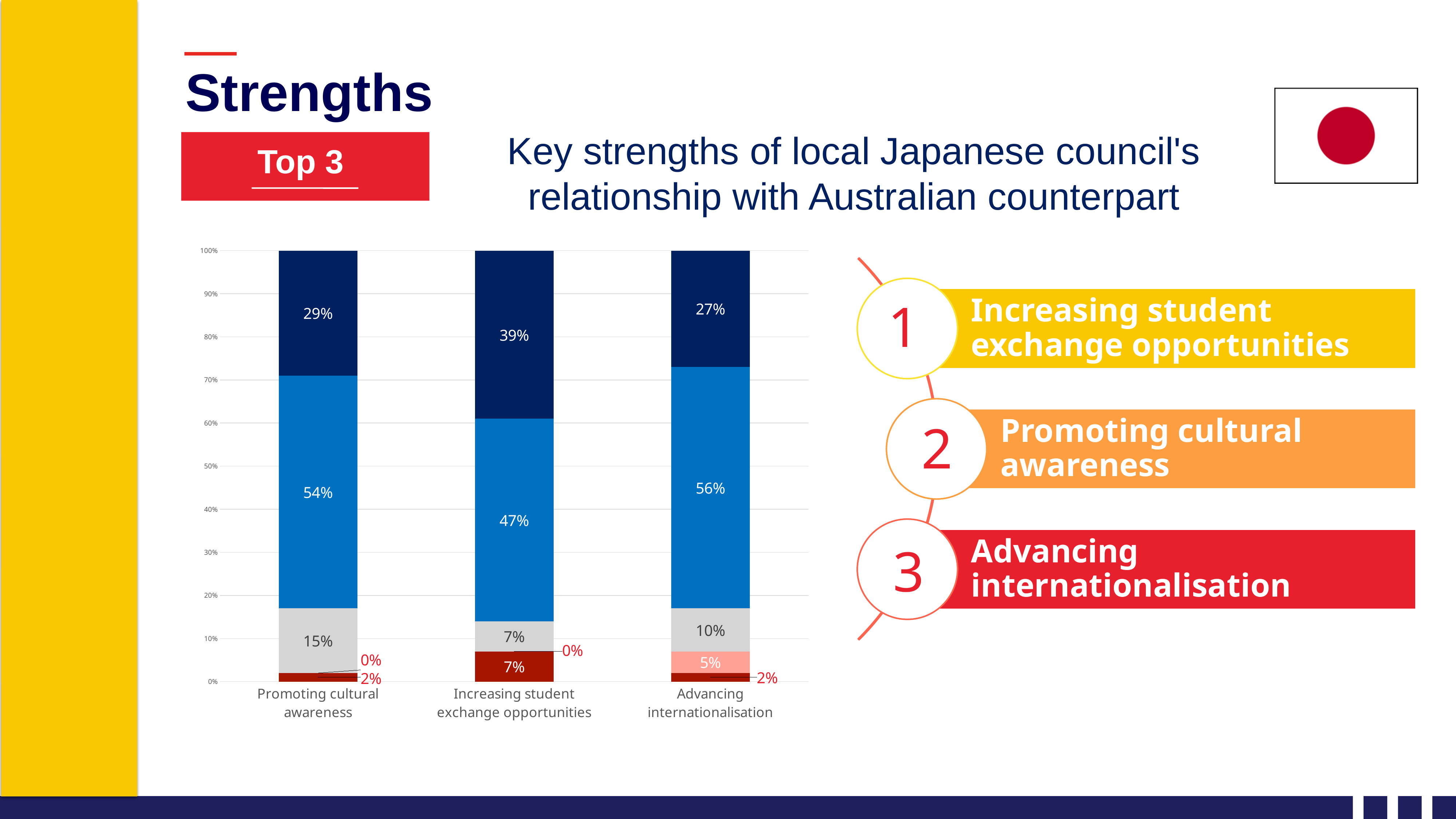
What is the value of the light pink segment for Advancing internationalisation? 5% How many categories are shown on the x axis of the chart? 3 Which category has the smallest grey segment? Increasing student exchange opportunities What is the value of the grey segment for Promoting cultural awareness? 15% What is the value of the dark navy top segment for Increasing student exchange opportunities? 39% Which is larger: the dark red bottom segment for Increasing student exchange opportunities or for Promoting cultural awareness? Increasing student exchange opportunities Which category has the largest dark navy top segment? Increasing student exchange opportunities What kind of chart is shown on the slide? stacked bar chart What is the title of the chart? Key strengths of local Japanese council's relationship with Australian counterpart What is the value of the mid-blue segment for Advancing internationalisation? 56% What is the value of the dark navy top segment for Promoting cultural awareness? 29% What is the difference between the mid-blue segment values for Advancing internationalisation and Increasing student exchange opportunities? 9%